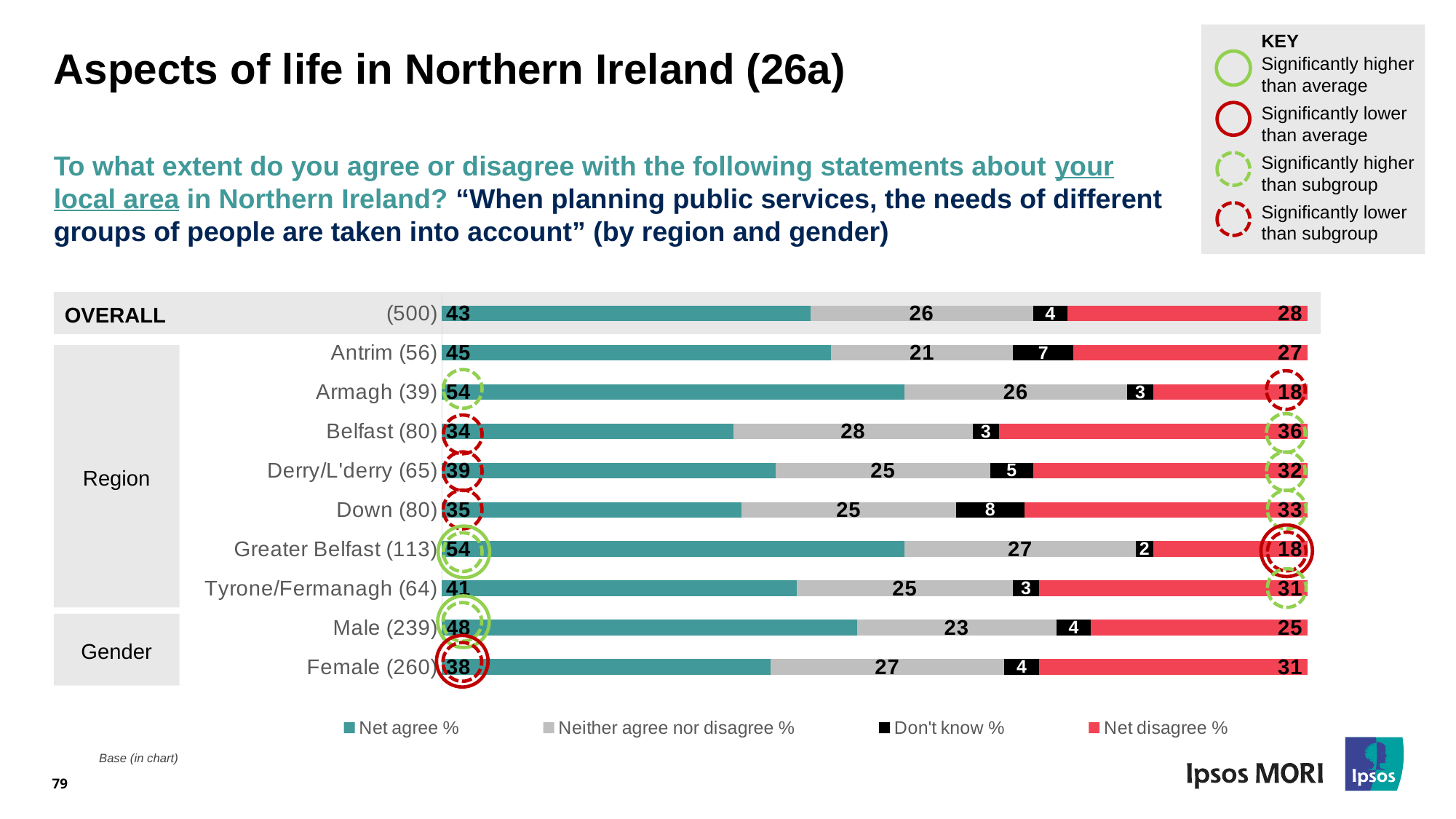
Which category has the highest Net disagree %? Belfast (80) What is the Net disagree % for Female (260)? 31 Which category has the lowest Net agree %? Belfast (80) Which category has the highest Don't know %? Down (80) What is the difference in Net agree % between Male (239) and Female (260)? 10 How many bars (categories) are shown in the chart? 10 What is the total of the four segments in the Male (239) bar? 100 What kind of chart is shown on the slide? Stacked bar chart What is the Don't know % for Down (80)? 8 How many series does the legend list? 4 What is the Net agree % for Belfast (80)? 34 Which has a higher Net agree %, Antrim (56) or Tyrone/Fermanagh (64)? Antrim (56)